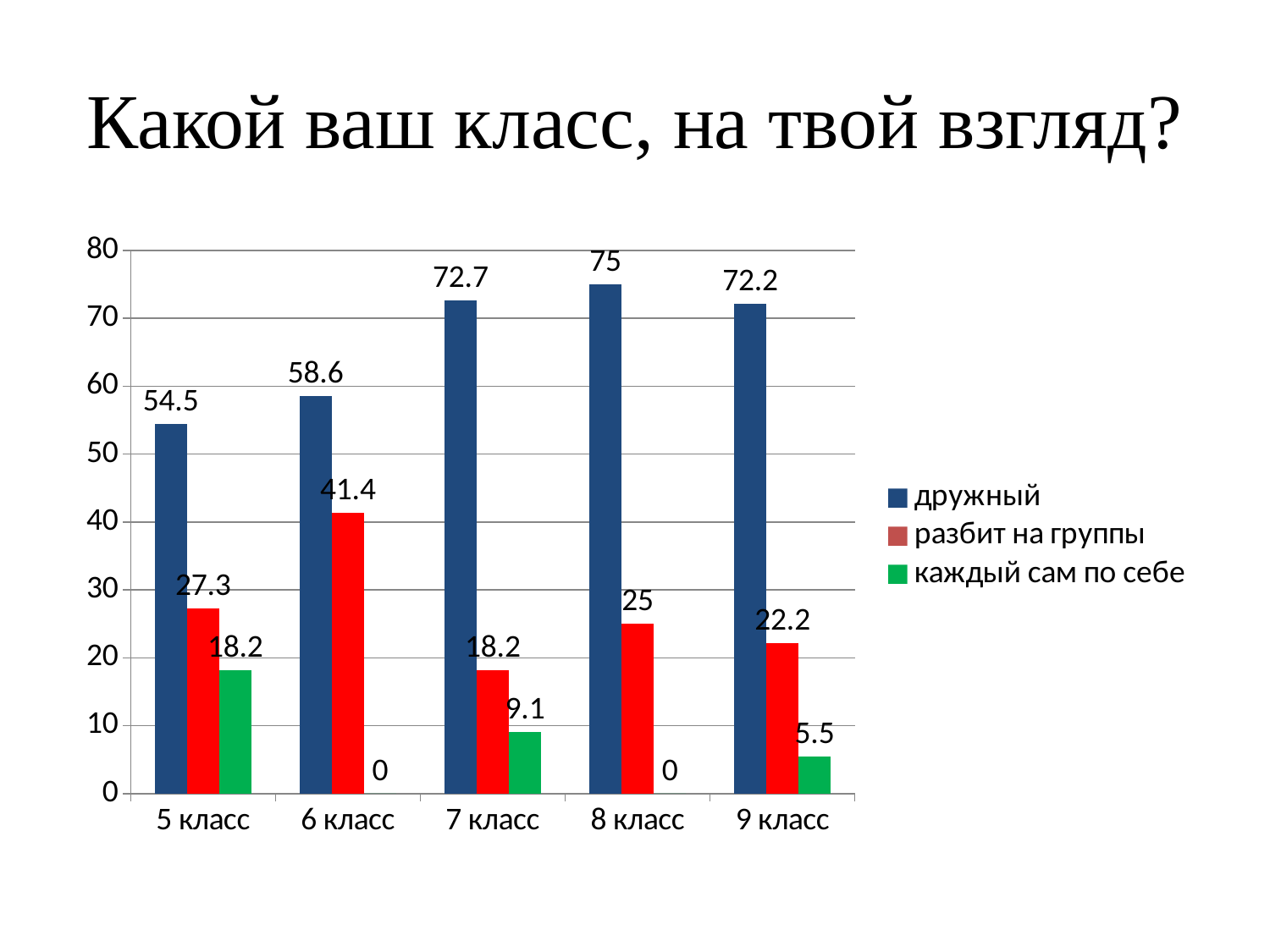
How many classes are shown on the x axis? 5 What kind of chart is shown on the slide? bar chart Is the value for "дружный" in 6 класс greater or less than 60? less Which is larger: the "разбит на группы" value for 5 класс or for 8 класс? 5 класс How many series does the legend list? 3 What is the difference between the "дружный" values for 8 класс and 5 класс? 20.5 What is the value for "дружный" in 8 класс? 75 Which class has the highest value for "разбит на группы"? 6 класс Which class has the highest value for "дружный"? 8 класс Which class has the lowest value for "дружный"? 5 класс What is the value for "каждый сам по себе" in 9 класс? 5.5 What is the value for "разбит на группы" in 6 класс? 41.4